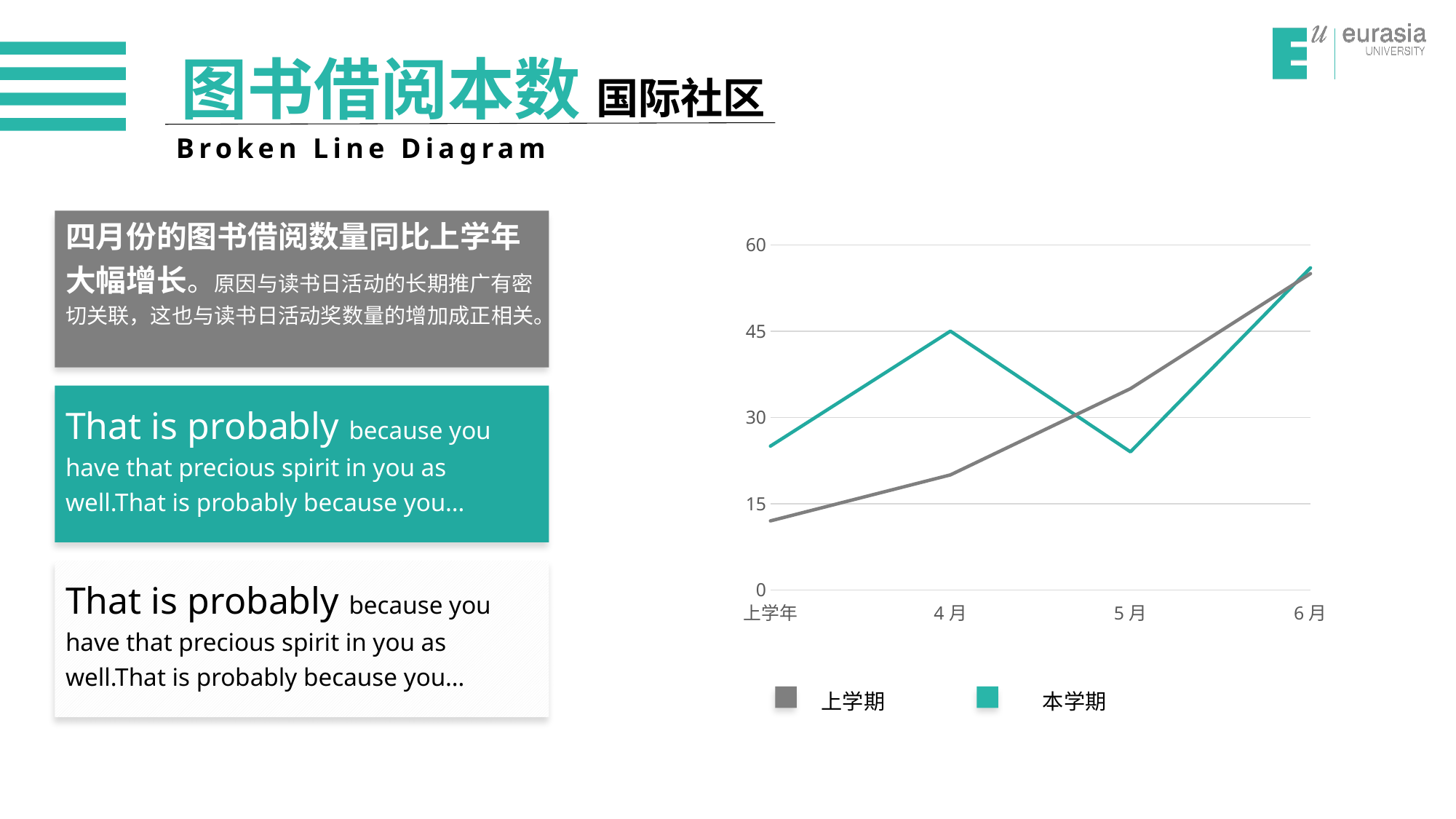
Is the value for 上学期 at 上学年 greater or less than 15? less Is the value for 本学期 at 4月 greater or less than 30? greater What kind of chart is shown on the slide? line chart At 5月, which series has the higher value, 上学期 or 本学期? 上学期 Is the value for 上学期 at 6月 greater or less than 45? greater For the 上学期 series, which category has the lowest value? 上学年 Do the values for the 上学期 series rise or fall along the x axis? rise Which colour is used for the 本学期 series in the chart? teal How many categories are shown on the x axis of the chart? 4 How many series does the chart legend list? 2 At 4月, which series has the higher value, 上学期 or 本学期? 本学期